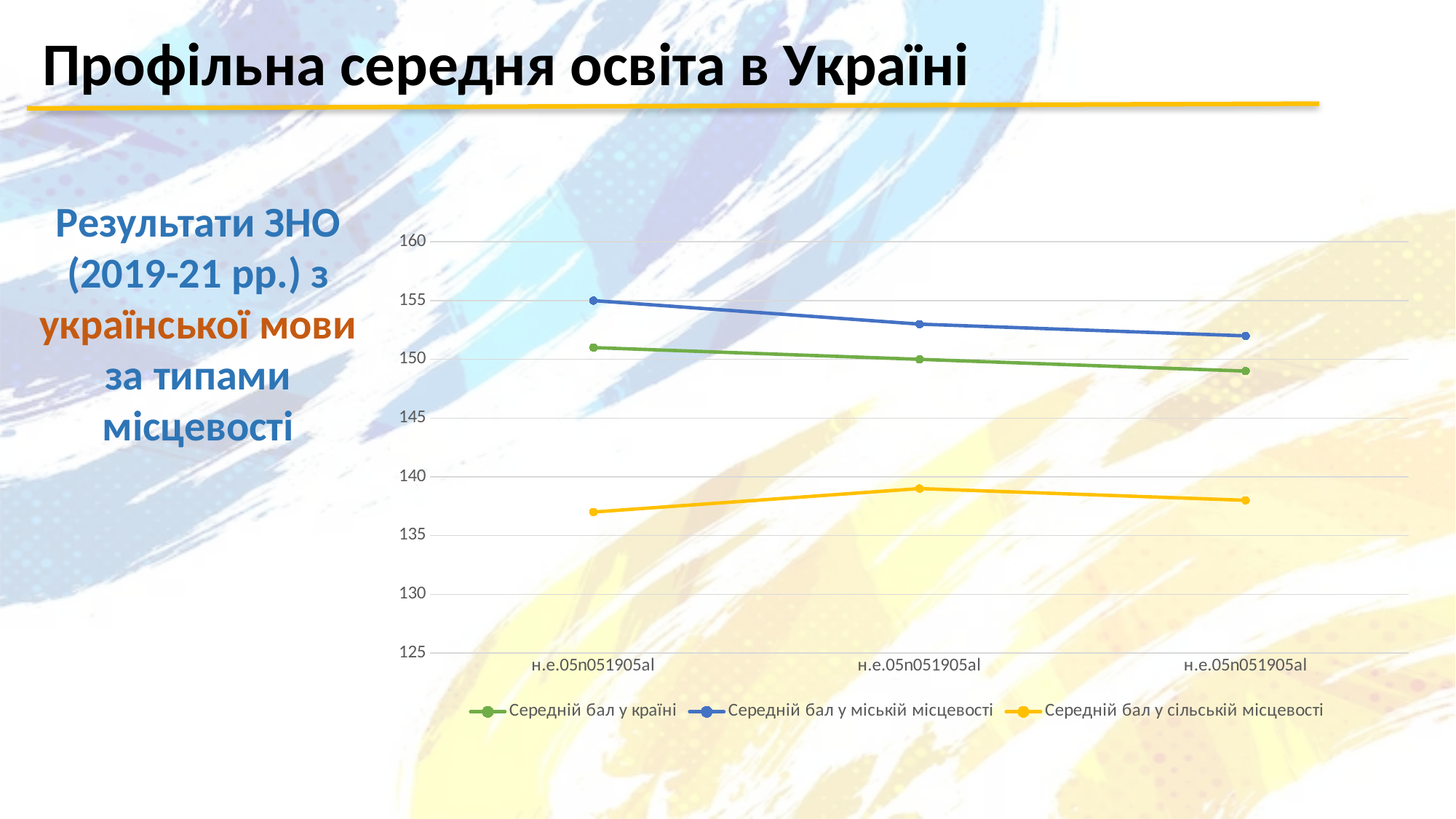
Which series has the lowest values across the chart? Середній бал у сільській місцевості How many series does the chart legend list? 3 At the first point, which is larger: 'Середній бал у міській місцевості' or 'Середній бал у країні'? Середній бал у міській місцевості What kind of chart is shown on the slide? line chart Is the first point of 'Середній бал у сільській місцевості' greater or less than 140? less What is the lowest value shown on the chart's vertical axis? 125 How many data points does each line in the chart have? 3 Which series has the highest values across the chart? Середній бал у міській місцевості What colour is the line for 'Середній бал у сільській місцевості'? yellow Is the last point of 'Середній бал у міській місцевості' greater or less than 150? greater Does the line for 'Середній бал у країні' rise or fall from left to right? fall Does the line for 'Середній бал у міській місцевості' rise or fall from left to right? fall